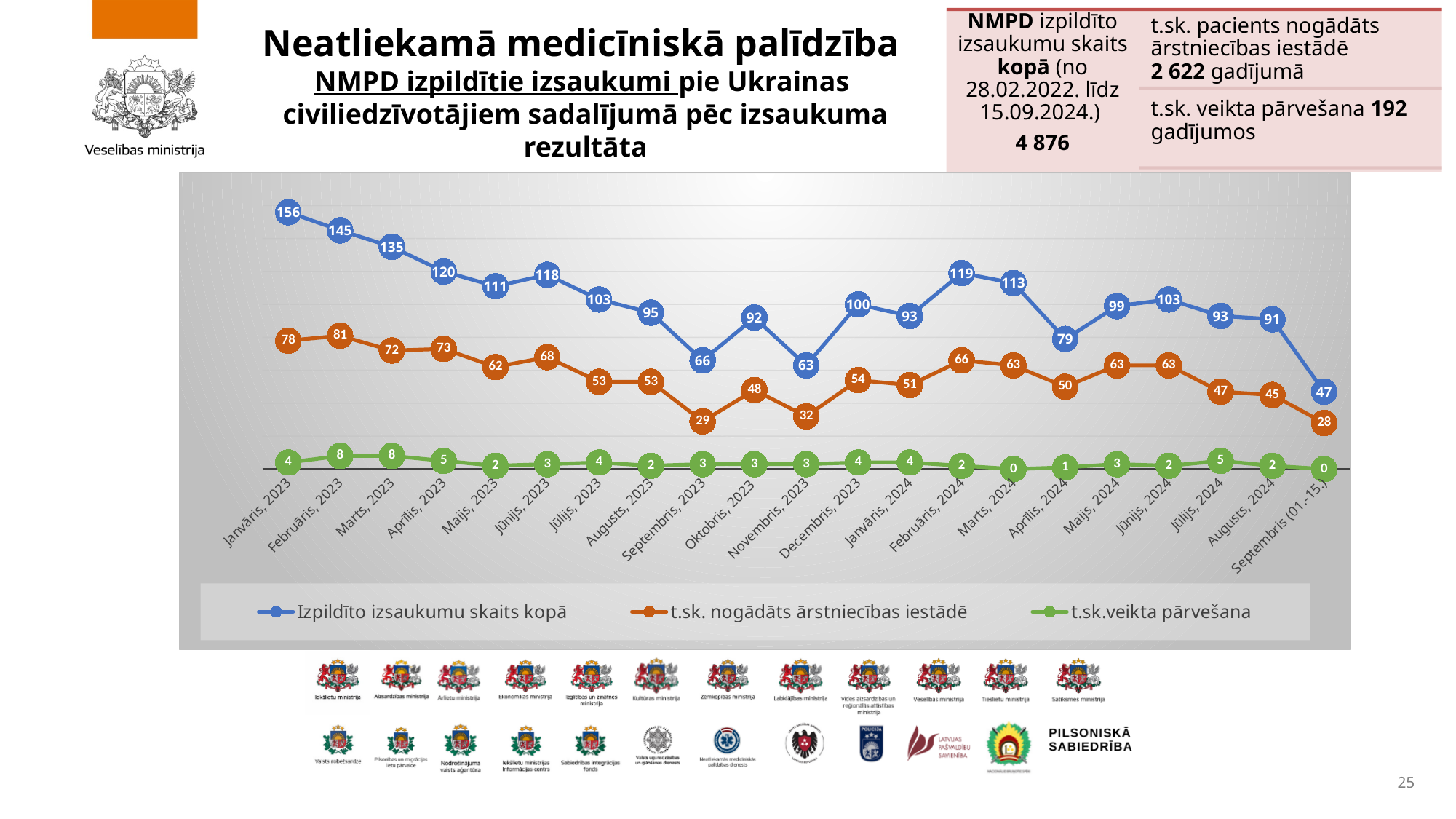
Does the 'Izpildīto izsaukumu skaits kopā' series rise or fall from Janvāris, 2023 to Maijs, 2023? Fall Which is larger: the 'Izpildīto izsaukumu skaits kopā' value for Oktobris, 2023 or for Novembris, 2023? Oktobris, 2023 What kind of chart is shown on the slide? Line chart What is the value of the 't.sk. nogādāts ārstniecības iestādē' series for Septembris, 2023? 29 In which month does the 't.sk. nogādāts ārstniecības iestādē' series reach its lowest value? Septembris (01.-15.) In which month does the 'Izpildīto izsaukumu skaits kopā' series reach its highest value? Janvāris, 2023 What is the value of the 't.sk.veikta pārvešana' series for Jūlijs, 2024? 5 What is the difference between the 'Izpildīto izsaukumu skaits kopā' values for Februāris, 2024 and Marts, 2024? 6 What is the value of the 'Izpildīto izsaukumu skaits kopā' series for Janvāris, 2023? 156 Which colour is used for the 't.sk.veikta pārvešana' series? Green How many series does the chart legend list? 3 How many months are plotted on the x axis of the chart? 21